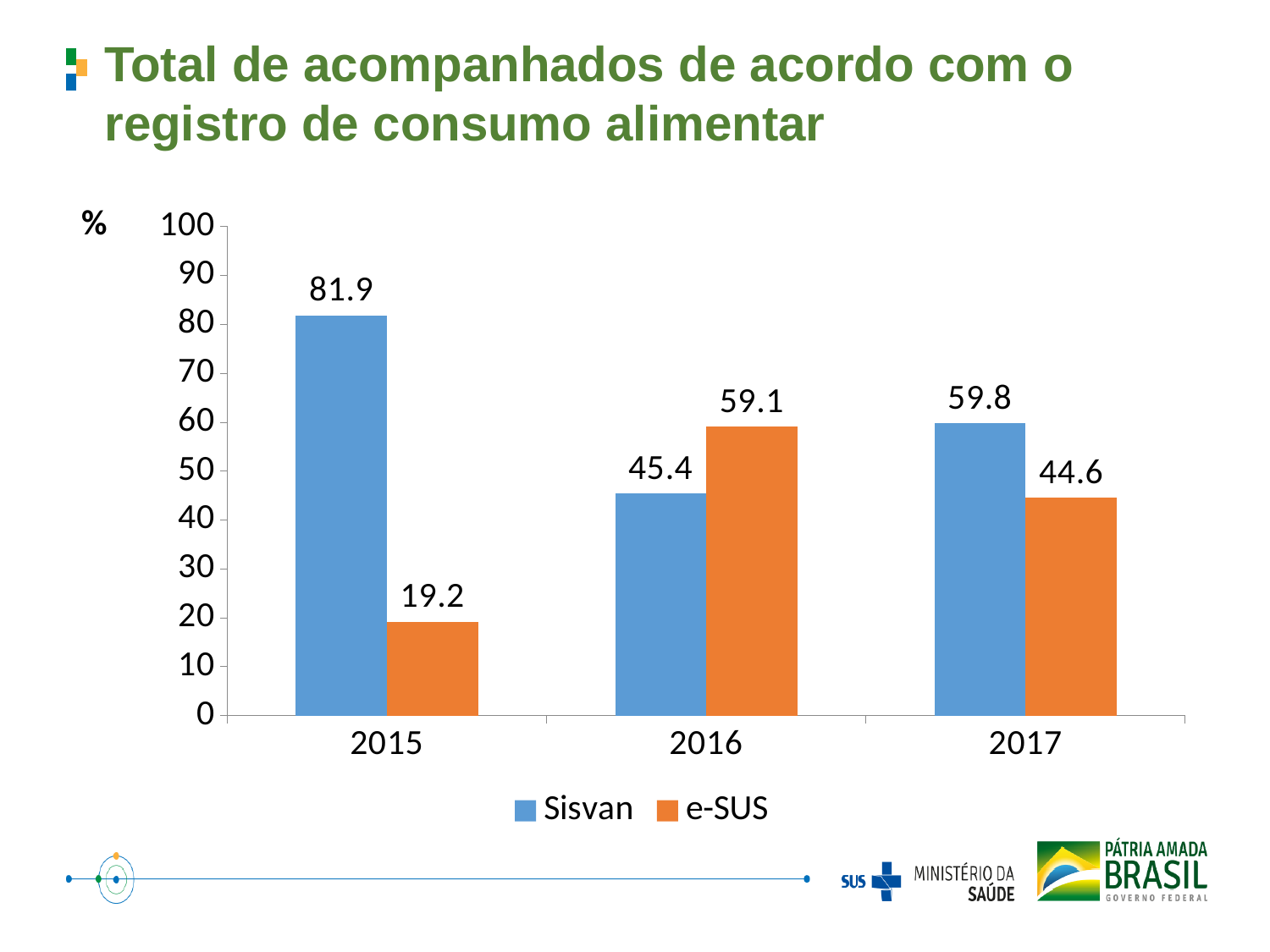
Does the e-SUS value rise or fall from 2015 to 2016? Rise How many years are shown on the x axis? 3 How many series does the legend list? 2 Which series has the larger value in 2017, Sisvan or e-SUS? Sisvan What is the difference between the Sisvan and e-SUS values in 2015? 62.7 In which year is the Sisvan value highest? 2015 What is the Sisvan value for 2015? 81.9 In which year is the e-SUS value lowest? 2015 What is the e-SUS value for 2017? 44.6 What is the e-SUS value for 2016? 59.1 What kind of chart is shown on the slide? Bar chart Which series has the larger value in 2016, Sisvan or e-SUS? e-SUS